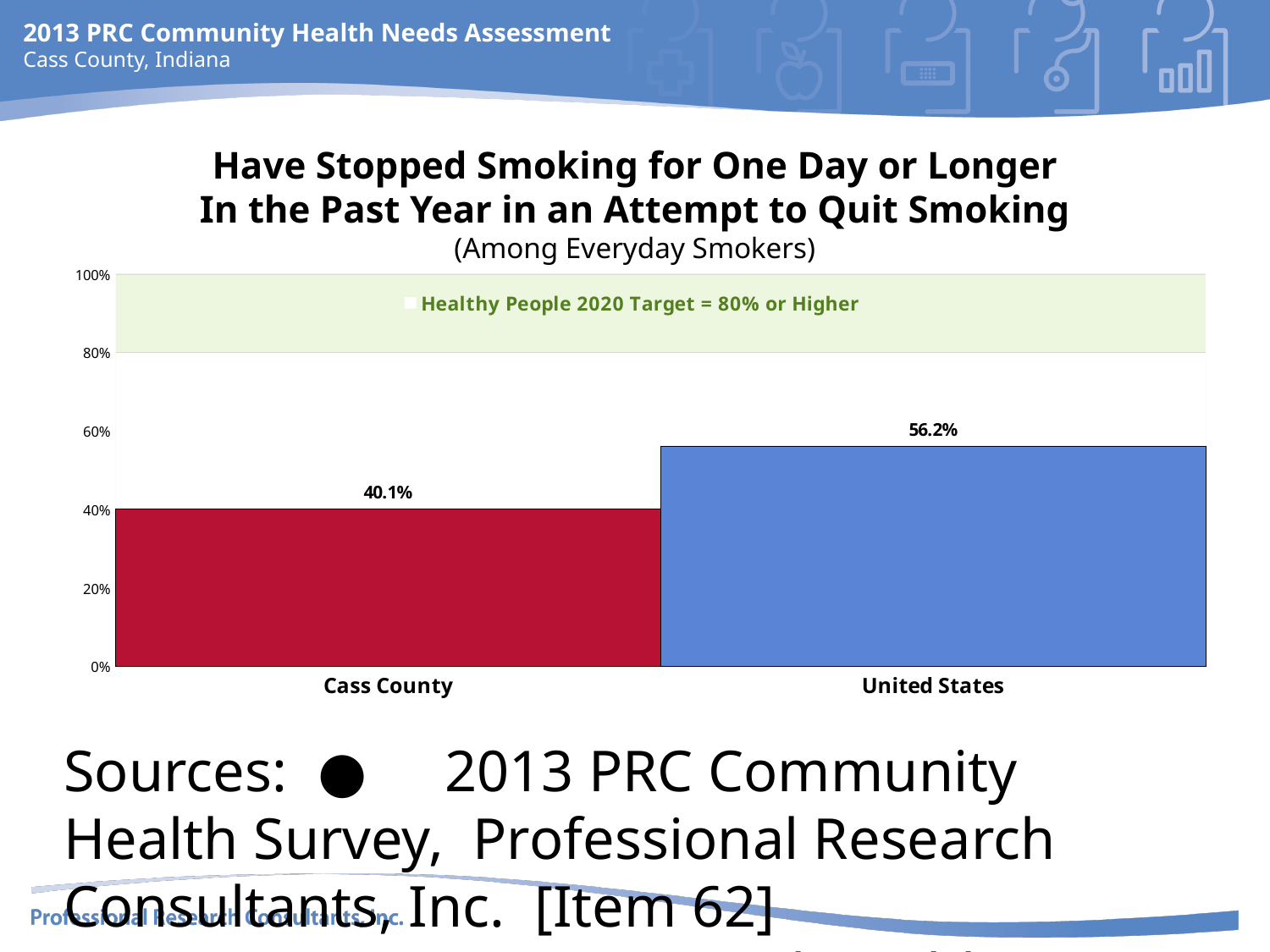
Which category has the lowest value? Cass County What is the difference between the United States value and the Cass County value? 16.1% What is the subtitle in parentheses under the chart title? (Among Everyday Smokers) Is the value for Cass County greater or less than 60%? less What is the value for United States? 56.2% Which category has the highest value? United States Which is larger, the value for Cass County or the value for United States? United States What kind of chart is shown on the slide? bar chart What is the value for Cass County? 40.1% How many categories are shown on the x axis? 2 What is the Healthy People 2020 Target shown on the chart? 80% or Higher Is the value for United States greater or less than 80%? less